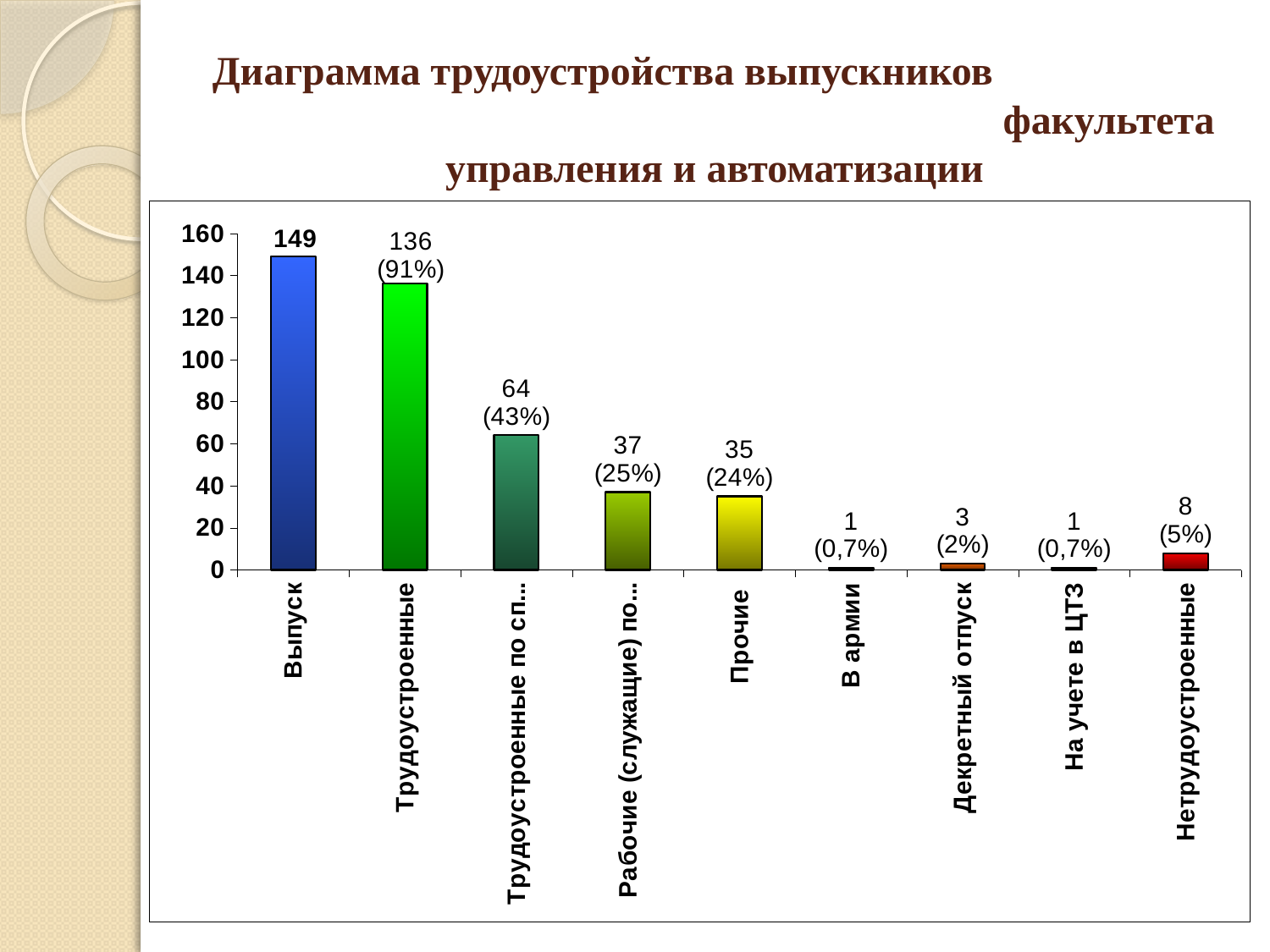
What type of chart is shown on the slide? bar chart Is the value for Выпуск greater or less than 140? greater What is the difference between the values for Выпуск and Трудоустроенные? 13 What is the value for Трудоустроенные? 136 Which is larger, the value for Прочие or the value for Нетрудоустроенные? Прочие What is the value for На учете в ЦТЗ? 1 What is the value for Нетрудоустроенные? 8 What percentage is shown for Трудоустроенные? 91% What percentage is shown for Декретный отпуск? 2% Which category has the highest value? Выпуск How many categories are shown on the x axis of the chart? 9 What is the value for Выпуск? 149